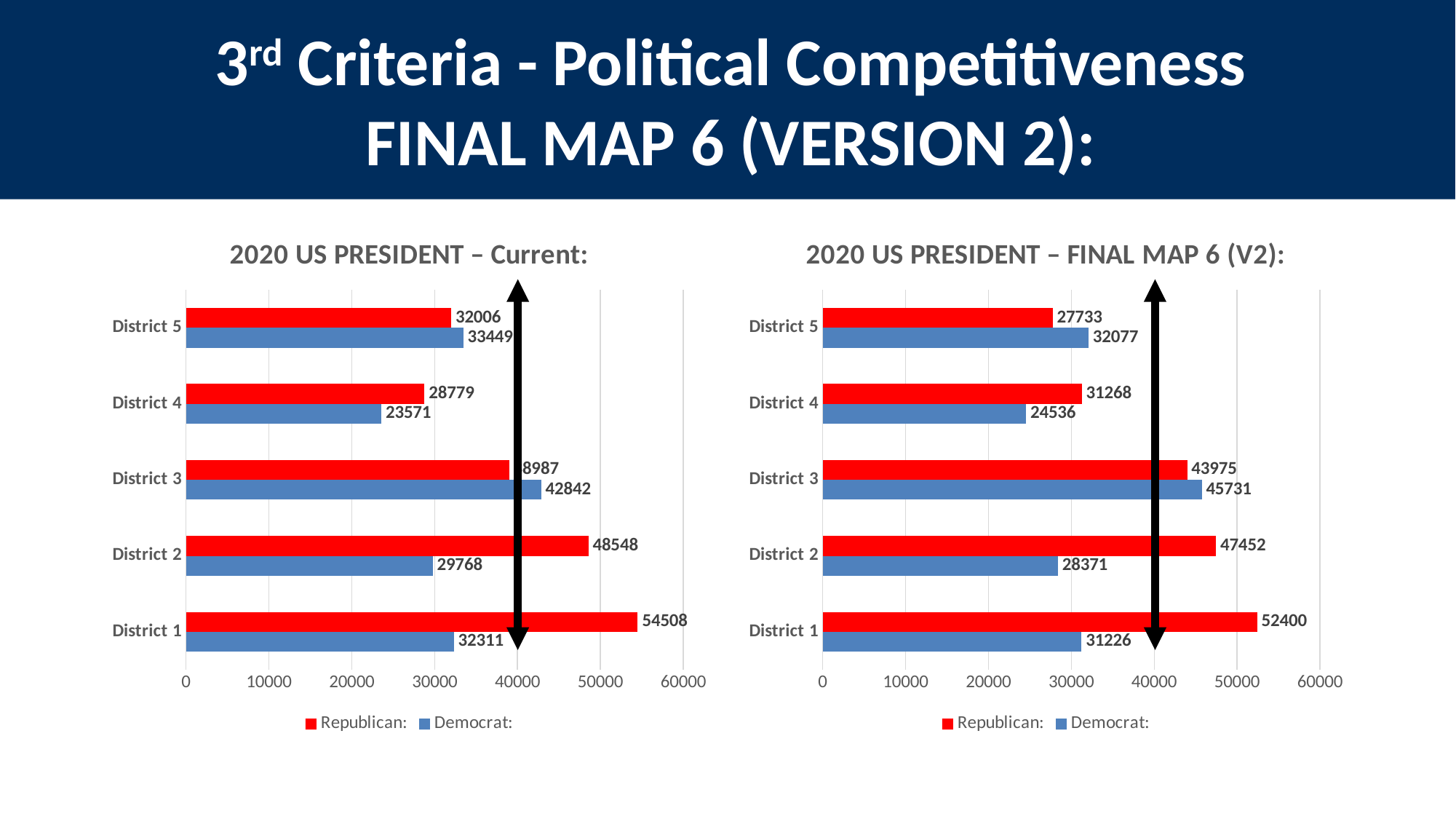
In the '2020 US PRESIDENT – Current:' chart, which district has the highest Republican value? District 1 In the '2020 US PRESIDENT – FINAL MAP 6 (V2):' chart, which is larger for District 4, the Republican or the Democrat value? Republican What kind of chart is the '2020 US PRESIDENT – FINAL MAP 6 (V2):' chart? Bar chart How many series does the legend of the '2020 US PRESIDENT – Current:' chart list? 2 In the '2020 US PRESIDENT – FINAL MAP 6 (V2):' chart, what is the difference between the Republican and Democrat values for District 1? 21174 In the '2020 US PRESIDENT – FINAL MAP 6 (V2):' chart, what is the Democrat value for District 3? 45731 In the '2020 US PRESIDENT – Current:' chart, what colour represents the Democrat series? Blue In the '2020 US PRESIDENT – Current:' chart, what is the Republican value for District 1? 54508 In the '2020 US PRESIDENT – FINAL MAP 6 (V2):' chart, what is the Republican value for District 5? 27733 In the '2020 US PRESIDENT – Current:' chart, is the Democrat value for District 3 greater or less than 40000? greater How many districts are shown in the '2020 US PRESIDENT – FINAL MAP 6 (V2):' chart? 5 In the '2020 US PRESIDENT – Current:' chart, which district has the lowest Democrat value? District 4